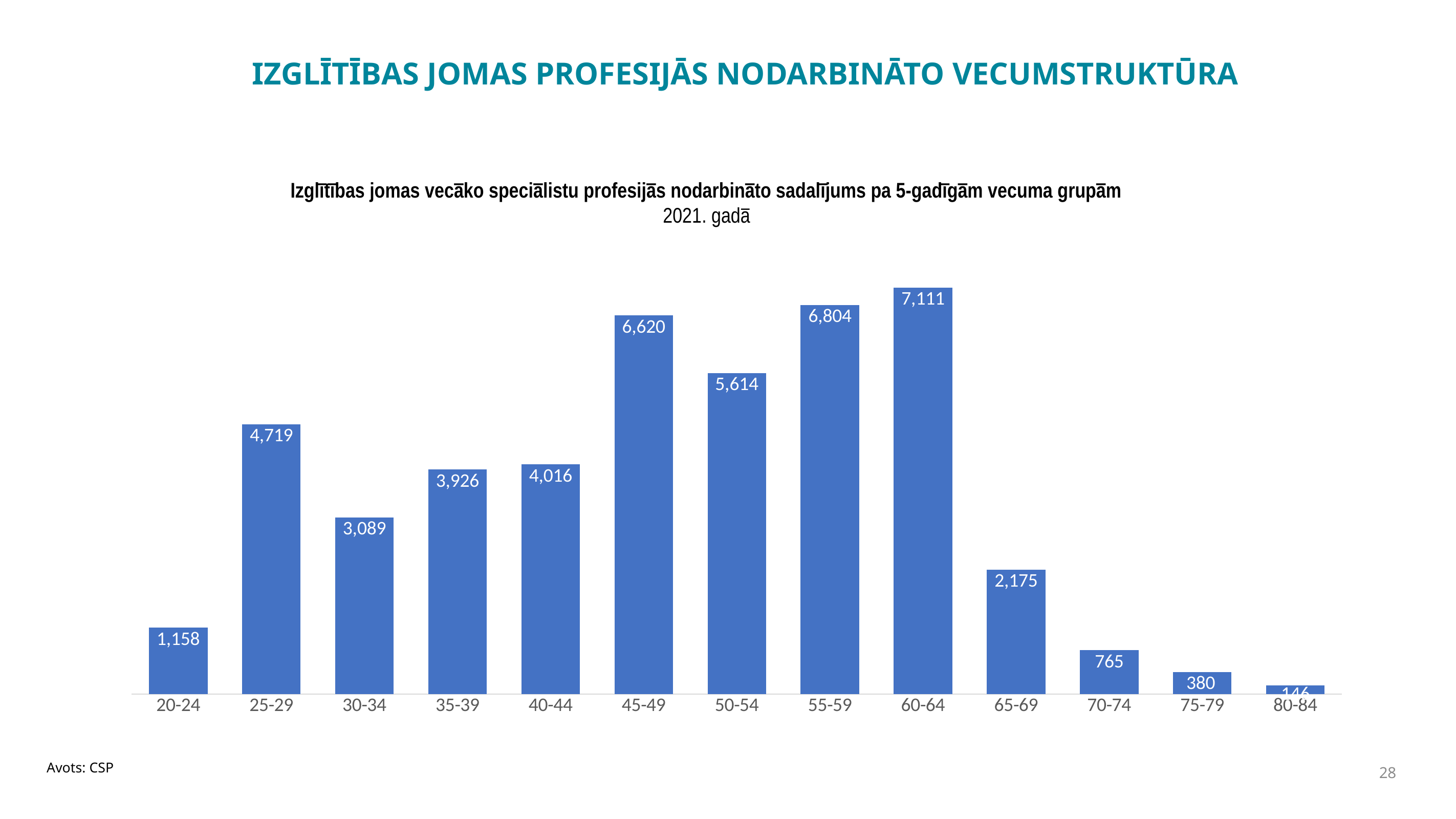
Which age group has the lowest value? 80-84 What is the value for the 45-49 age group? 6,620 How many age groups are shown on the x axis of the chart? 13 Which age group has the highest value? 60-64 What is the value for the 60-64 age group? 7,111 What is the difference between the values for the 60-64 and 55-59 age groups? 307 Which year does the chart title say the data is for? 2021 What is the value for the 70-74 age group? 765 Which has a larger value, the 30-34 age group or the 65-69 age group? 30-34 What is the value for the 20-24 age group? 1,158 What type of chart is shown on the slide? bar chart What is the difference between the values for the 25-29 and 20-24 age groups? 3,561